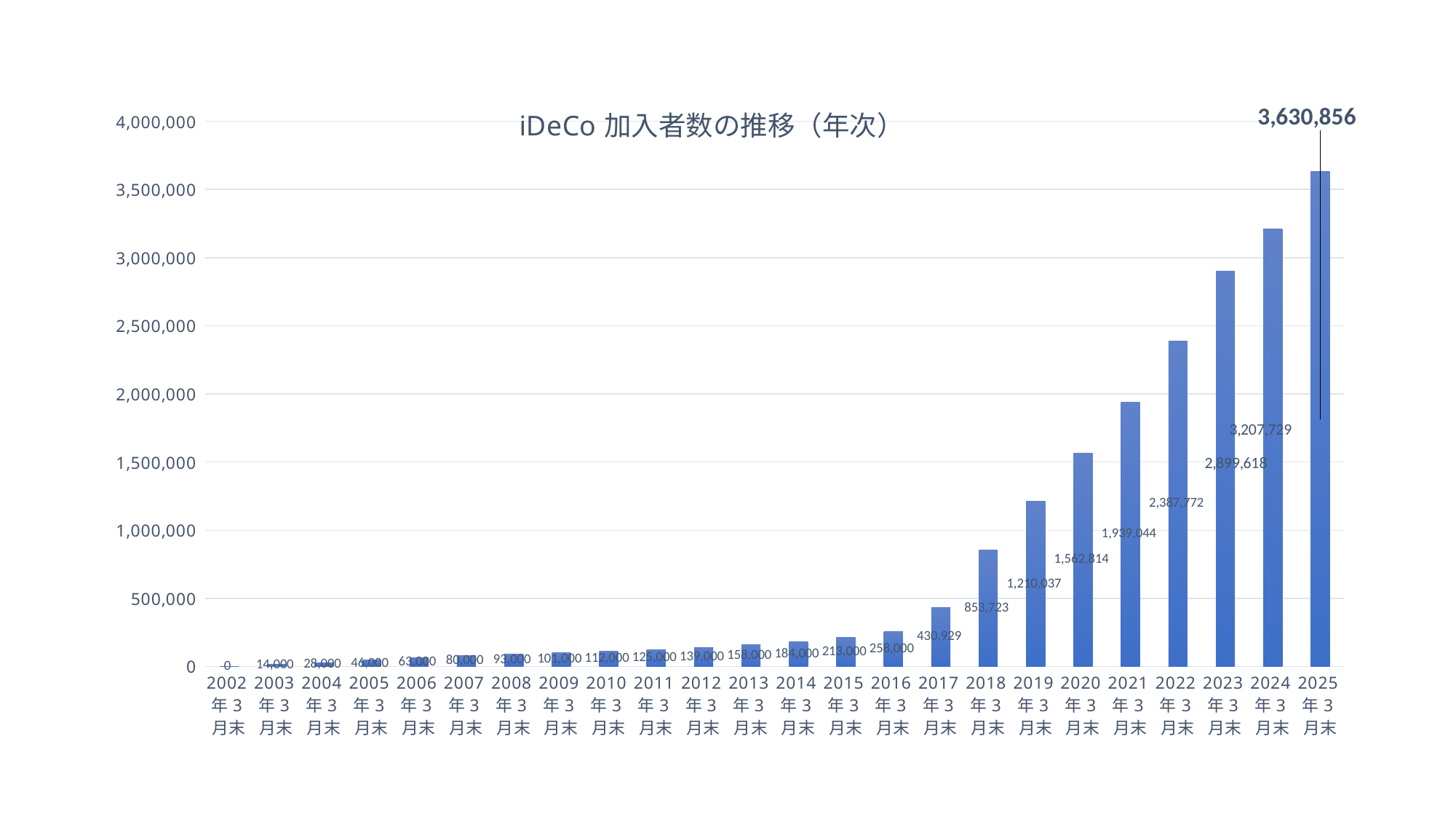
Do the values rise or fall from 2002年3月末 to 2025年3月末? rise What is the title of the chart? iDeCo 加入者数の推移（年次） What is the value for 2021年3月末? 1,939,044 What kind of chart is this? bar chart Which is larger, the value for 2019年3月末 or 2020年3月末? 2020年3月末 Is the value for 2023年3月末 greater or less than 2,500,000? greater What is the difference between the values for 2025年3月末 and 2024年3月末? 423,127 Which year has the highest value? 2025年3月末 What is the value for 2025年3月末? 3,630,856 Which year has the lowest value? 2002年3月末 How many years (bars) are shown in the chart? 24 What is the value for 2018年3月末? 853,723